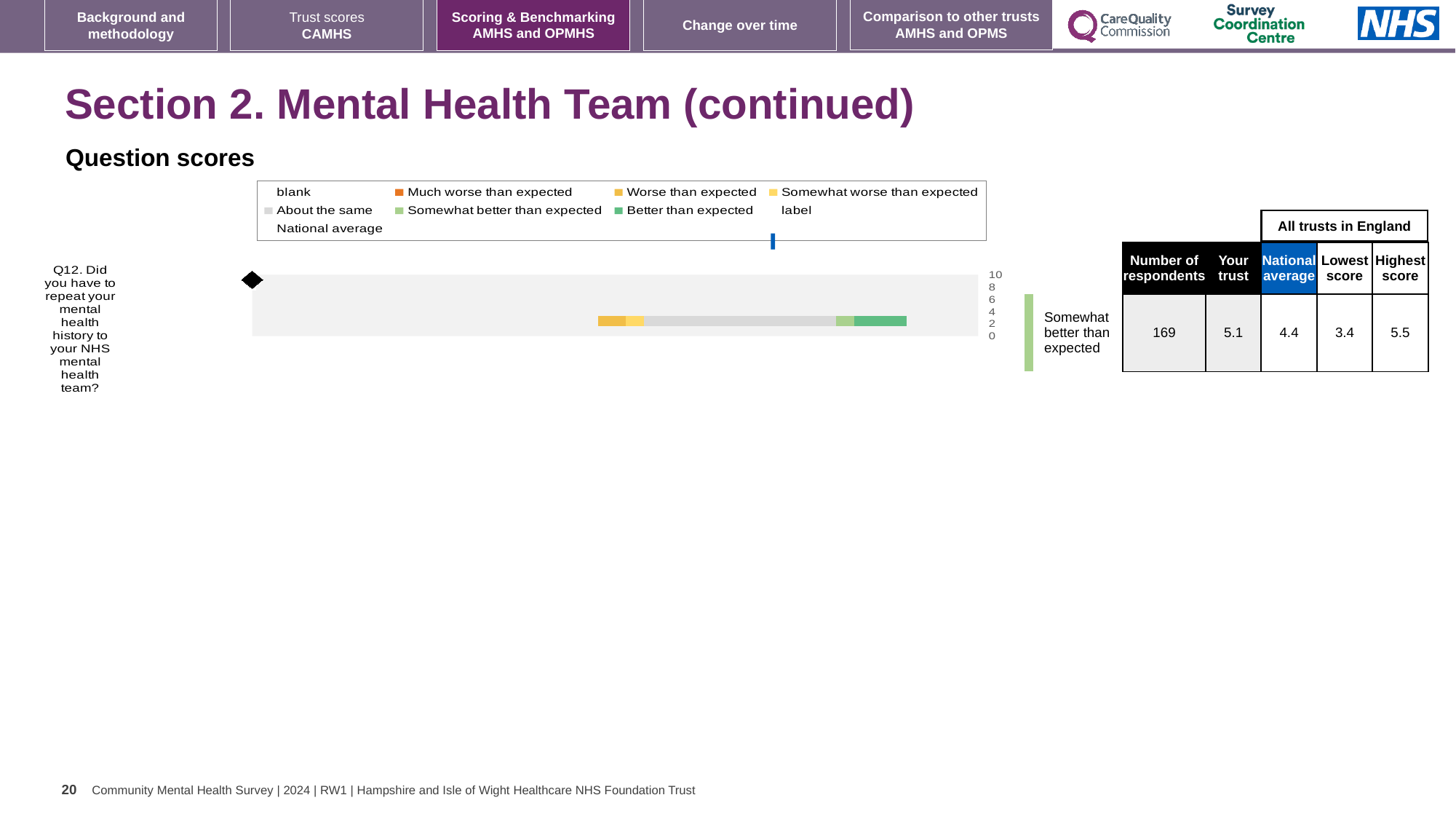
Which is larger for Q12, the 'Your trust' score or the national average? Your trust What is the lowest score among all trusts in England for Q12? 3.4 Is the 'Your trust' score for Q12 greater or less than 4? greater Which question is plotted in the chart? Q12. Did you have to repeat your mental health history to your NHS mental health team? How many survey questions are plotted in the chart? 1 What kind of chart is used to show the Q12 question score? bar chart What is the national average score for Q12? 4.4 What is the 'Your trust' score for Q12? 5.1 What is the highest score among all trusts in England for Q12? 5.5 What is the difference between the highest and lowest scores for Q12 across all trusts in England? 2.1 How many respondents answered Q12? 169 What benchmark rating is shown next to the chart for Q12? Somewhat better than expected